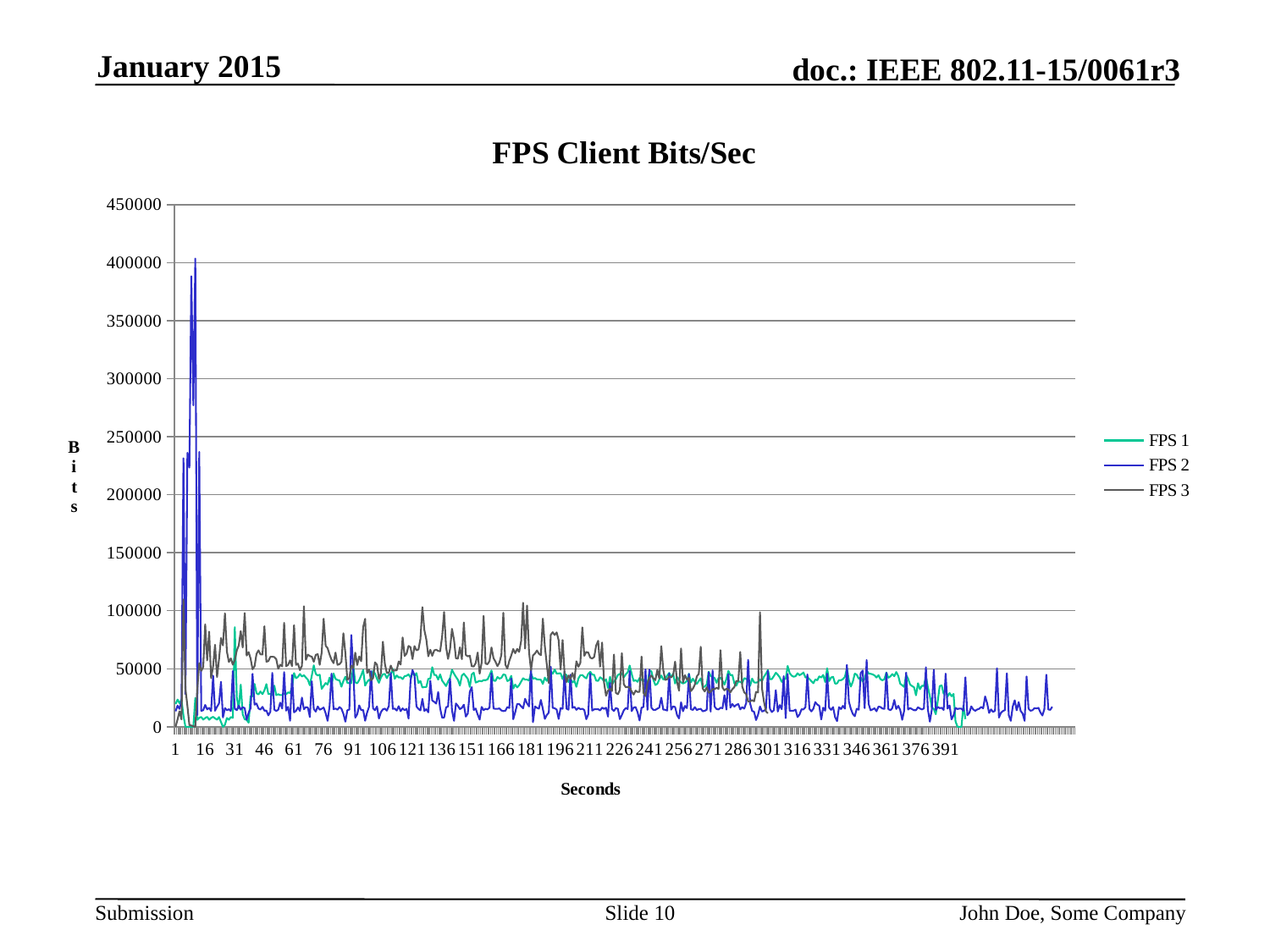
Is the highest peak of FPS 3 greater or less than 300000? less Between seconds 46 and 196, which series is generally higher, FPS 2 or FPS 3? FPS 3 What is the title of the chart? FPS Client Bits/Sec Near the end of the series (around second 391), is the value for FPS 1 greater or less than 50000? less What kind of chart is shown on the slide? line chart How many series does the legend list? 3 What is the label of the x axis? Seconds After its initial spike, do the FPS 3 values generally rise or fall along the x axis? fall Which series reaches the highest peak on the chart? FPS 2 Is the highest value of FPS 1 greater or less than 100000? less